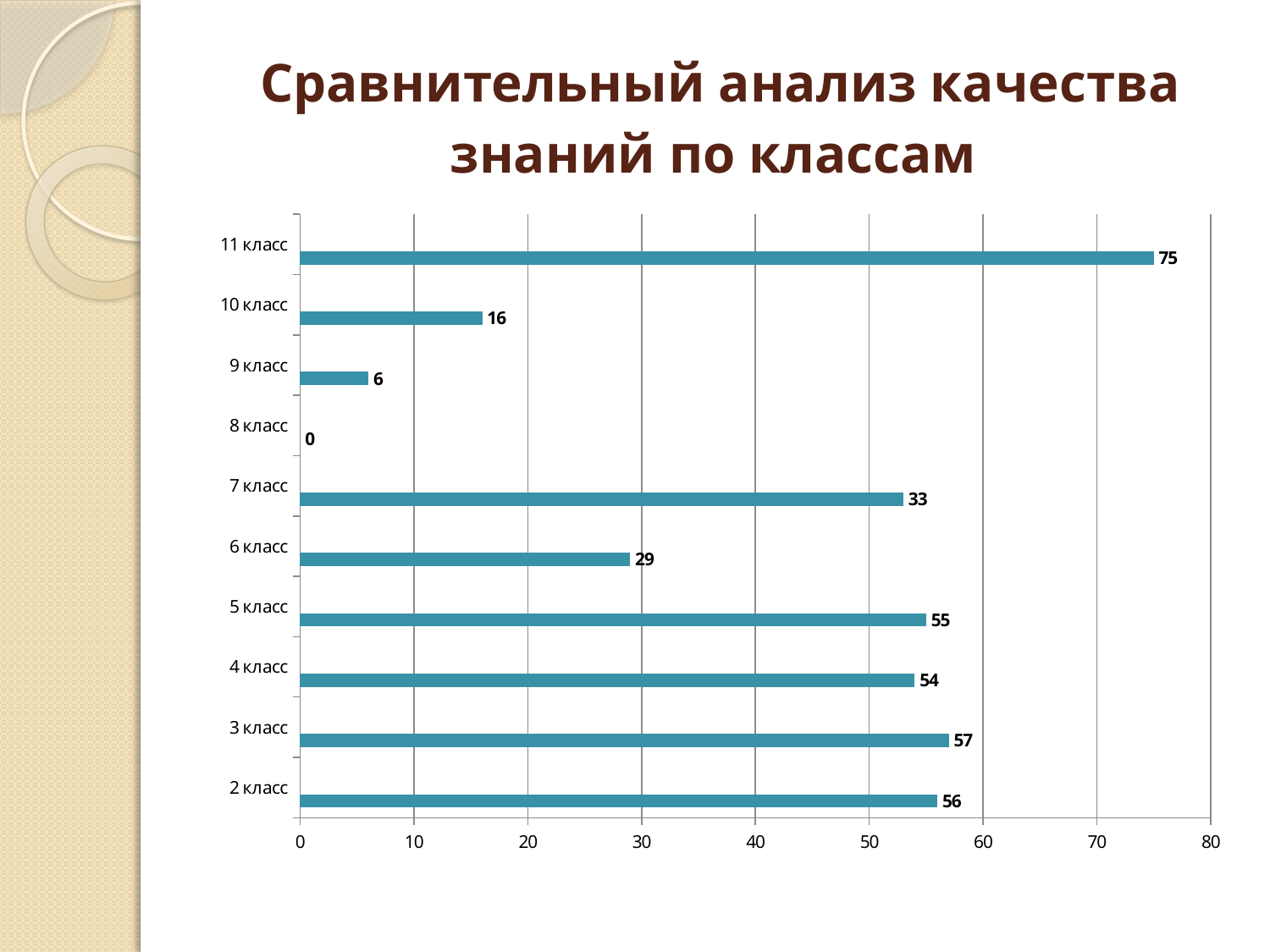
Which class has the highest value? 11 класс How many classes are shown on the chart? 10 What is the title of the slide? Сравнительный анализ качества знаний по классам What kind of chart is shown on the slide? bar chart What is the difference between the values for 3 класс and 4 класс? 3 What is the value for 8 класс? 0 Which class has the lowest value? 8 класс What is the value for 6 класс? 29 What is the difference between the values for 11 класс and 10 класс? 59 What is the value for 11 класс? 75 Is the value for 3 класс greater or less than 50? greater Which is larger, the value for 7 класс or the value for 6 класс? 7 класс